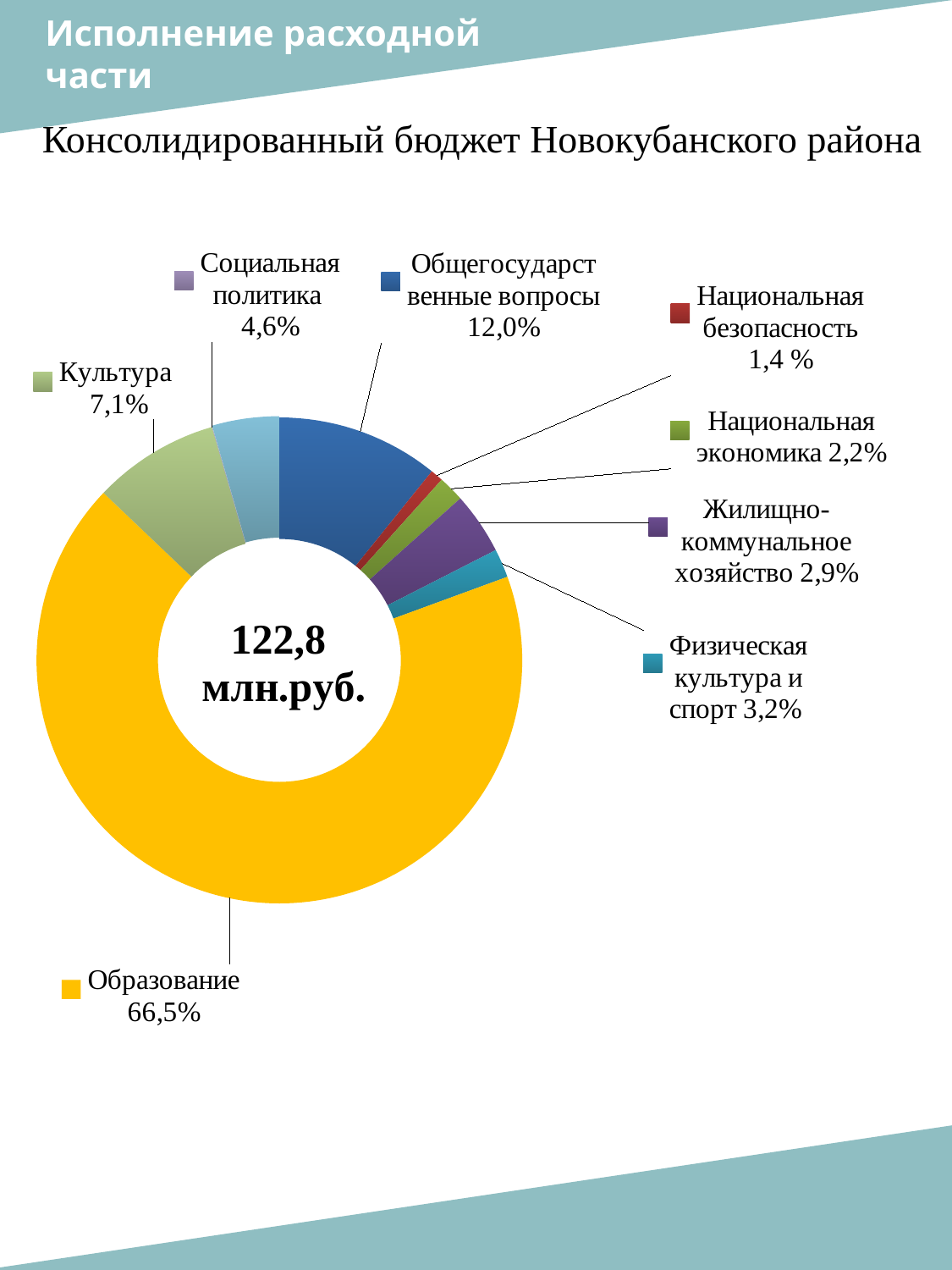
What share of the budget goes to Образование? 66,5% What share of the budget goes to Культура? 7,1% What share of the budget goes to Национальная безопасность? 1,4 % Which has a larger share: Социальная политика or Жилищно-коммунальное хозяйство? Социальная политика Which category has the smallest share of the budget? Национальная безопасность What kind of chart is shown on the slide? Doughnut (pie) chart Which category has the largest share of the budget? Образование What is the difference in percentage points between Общегосударственные вопросы and Культура? 4,9 How many categories are shown in the chart? 8 What share of the budget goes to Общегосударственные вопросы? 12,0% What total amount is shown in the centre of the chart? 122,8 млн.руб. What share of the budget goes to Физическая культура и спорт? 3,2%